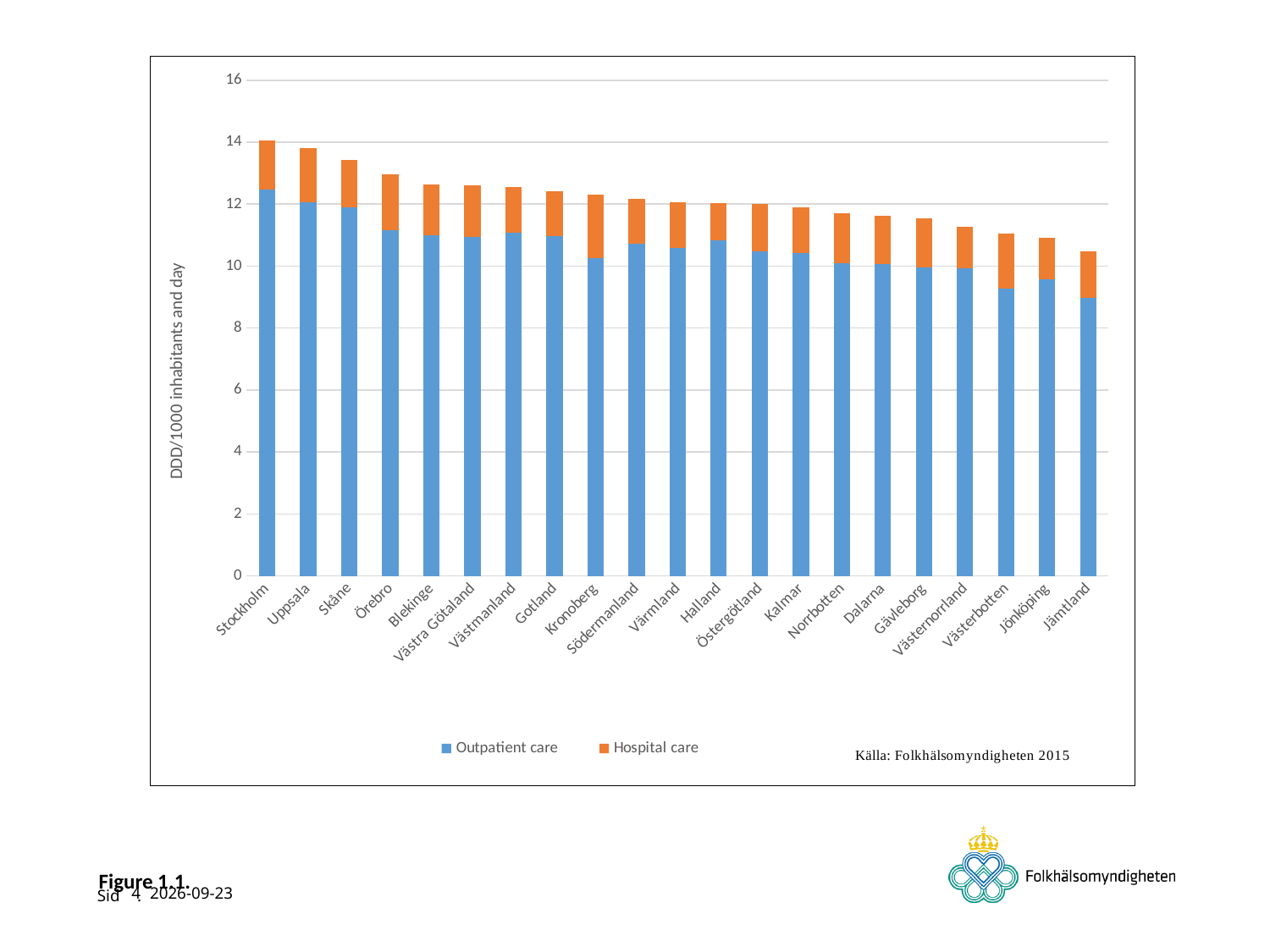
Which has the larger total bar, Stockholm or Jämtland? Stockholm Is the total bar for Uppsala greater or less than 12? greater What kind of chart is shown on the slide? Stacked bar chart Which region has the lowest total bar? Jämtland Is the Outpatient care value for Stockholm greater or less than 12? greater How many series does the legend list? 2 Is the Outpatient care value for Jämtland greater or less than 10? less How many regions (categories) are shown on the x axis? 21 Which region has the highest total bar? Stockholm Do the total bar heights rise or fall from left to right along the x axis? Fall What is the label on the y axis? DDD/1000 inhabitants and day